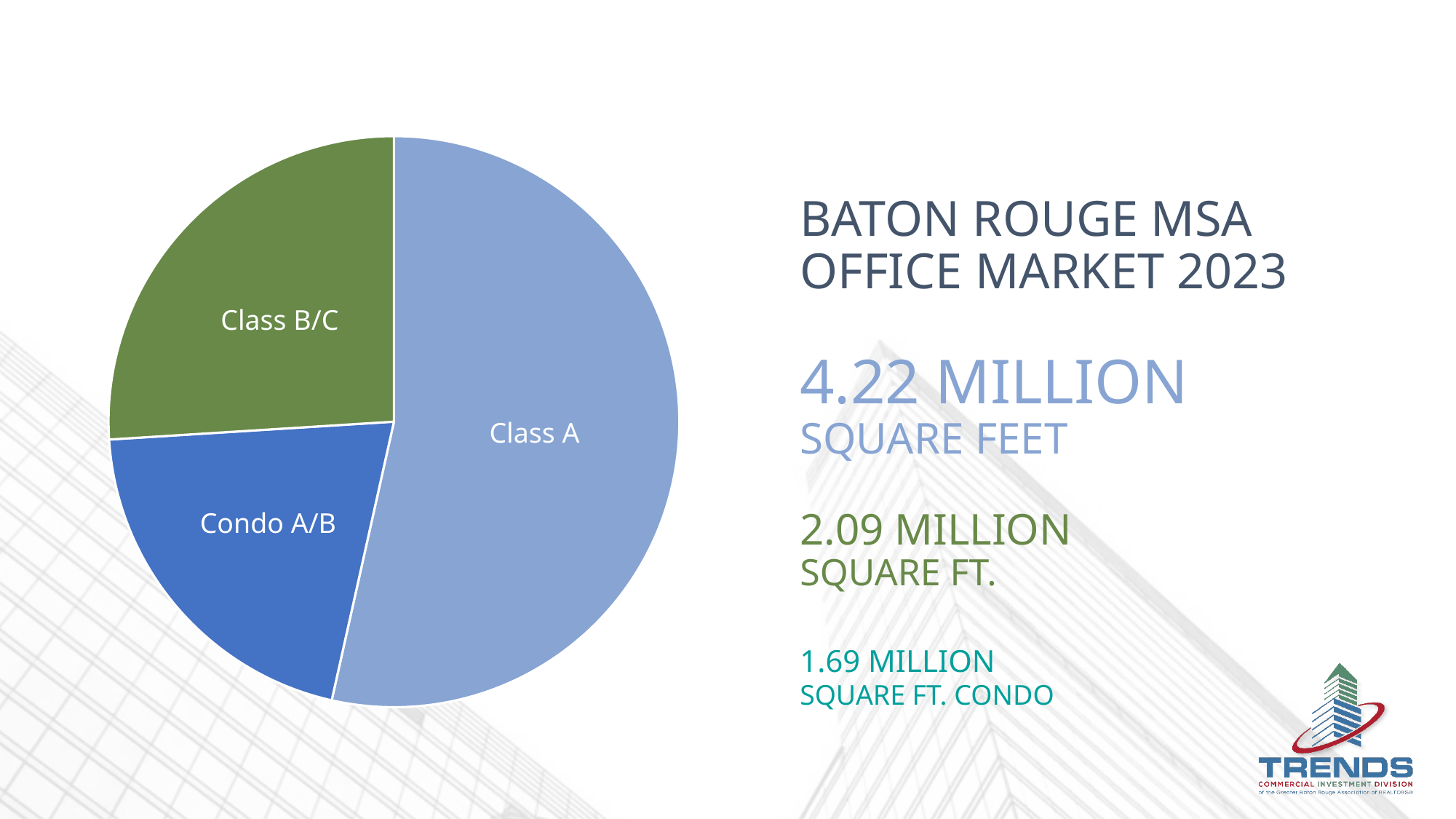
What colour is the Class B/C slice of the pie chart? green How many slices does the pie chart have? 3 What is the title shown next to the pie chart? Baton Rouge MSA Office Market 2023 Which slice of the pie chart is the largest? Class A Which slice is larger, Class B/C or Condo A/B? Class B/C Does the Class A slice account for more or less than half of the pie? more How many square feet does the slide give for Class B/C office space? 2.09 million square ft. What kind of chart is shown on the slide? pie chart How many square feet does the slide give for condo office space? 1.69 million square ft. By how many million square feet does Class A exceed Class B/C? 2.13 million Which slice of the pie chart is the smallest? Condo A/B How many square feet does the slide give for Class A office space? 4.22 million square feet